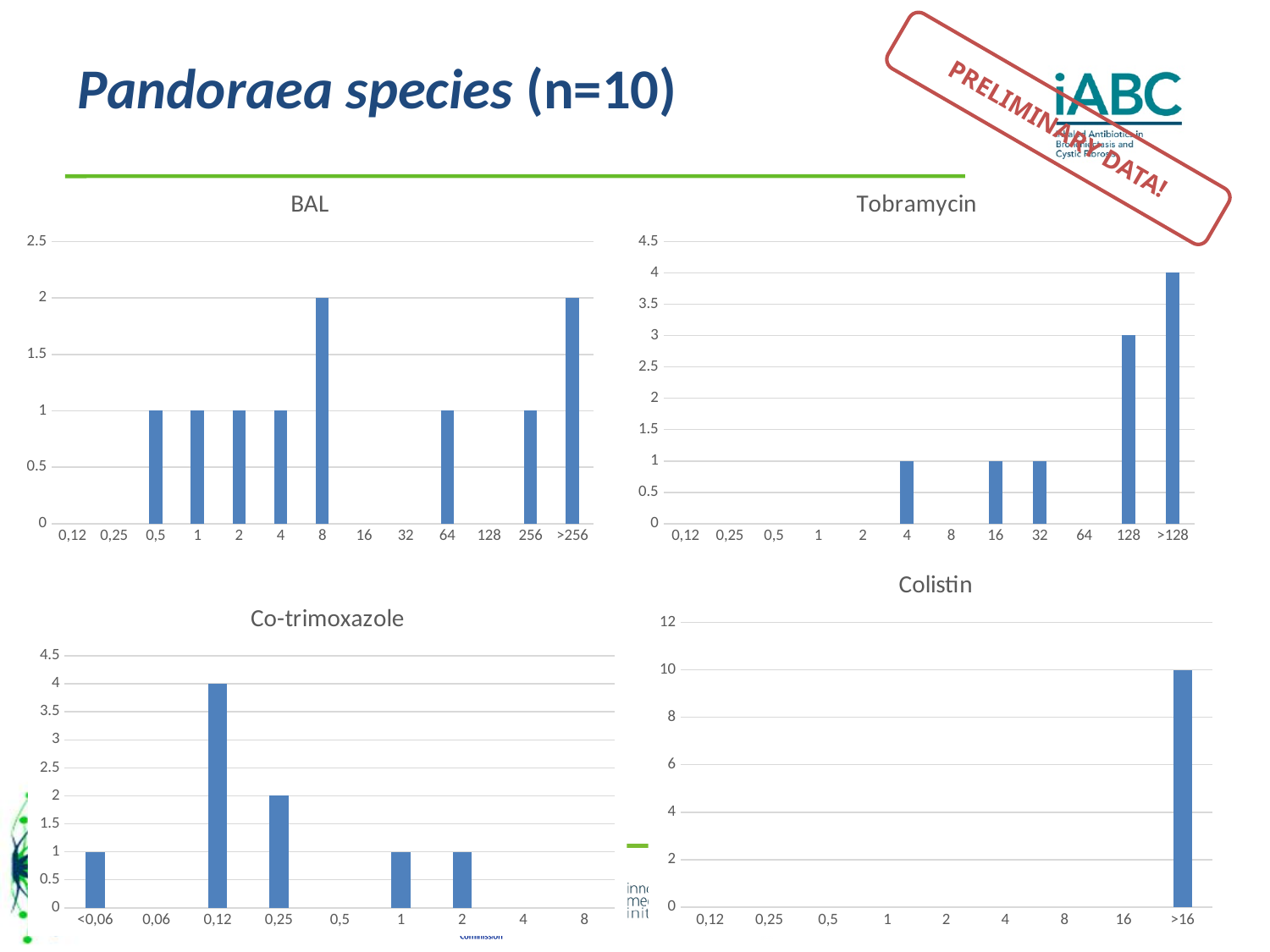
How many x-axis categories does the Colistin chart show? 9 In the BAL chart, which is larger, the value for 8 or the value for 64? 8 How many charts are on the slide? 4 In the Co-trimoxazole chart, what is the difference between the values for 0,12 and 0,25? 2 In the Co-trimoxazole chart, which category has the highest value? 0,12 In the Tobramycin chart, what is the value for 128? 3 In the Tobramycin chart, what is the value for >128? 4 In the Colistin chart, what is the value for >16? 10 In the Tobramycin chart, which category has the highest value? >128 In the BAL chart, what is the value for 8? 2 What kind of chart is the Tobramycin chart? bar chart In the Co-trimoxazole chart, what is the value for 0,25? 2